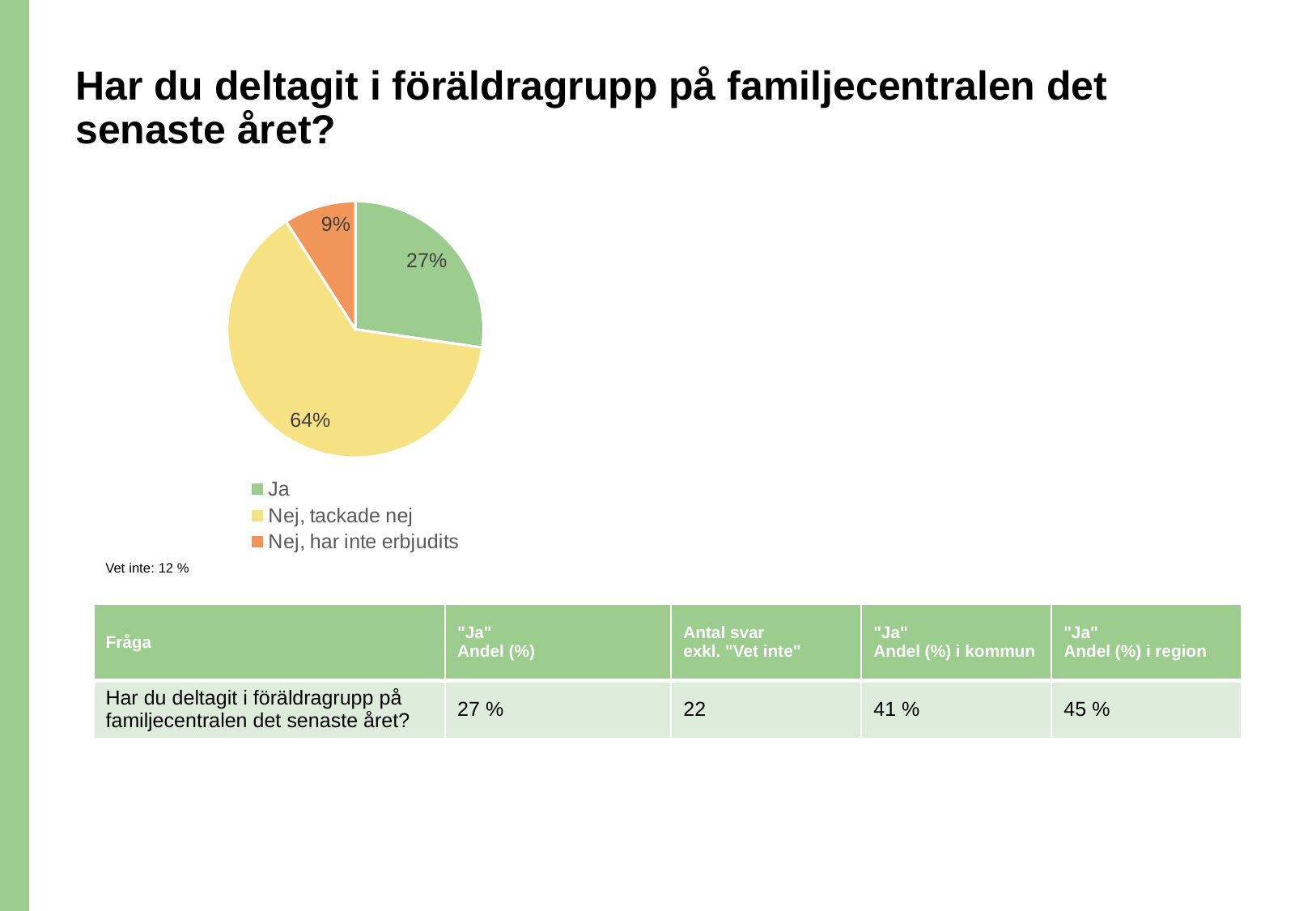
Which is larger, the slice for "Ja" or the slice for "Nej, har inte erbjudits"? Ja Which category has the smallest slice of the pie? Nej, har inte erbjudits What share of the pie does "Nej, tackade nej" represent? 64% How many slices does the pie chart have? 3 What is the difference in percentage points between "Nej, tackade nej" and "Ja"? 37 What kind of chart is shown on the slide? pie chart How many entries does the legend list? 3 What colour is the slice for "Nej, tackade nej"? yellow What is the "Vet inte" percentage noted below the chart? 12 % What share of the pie does "Nej, har inte erbjudits" represent? 9% Which category has the largest slice of the pie? Nej, tackade nej What share of the pie does "Ja" represent? 27%